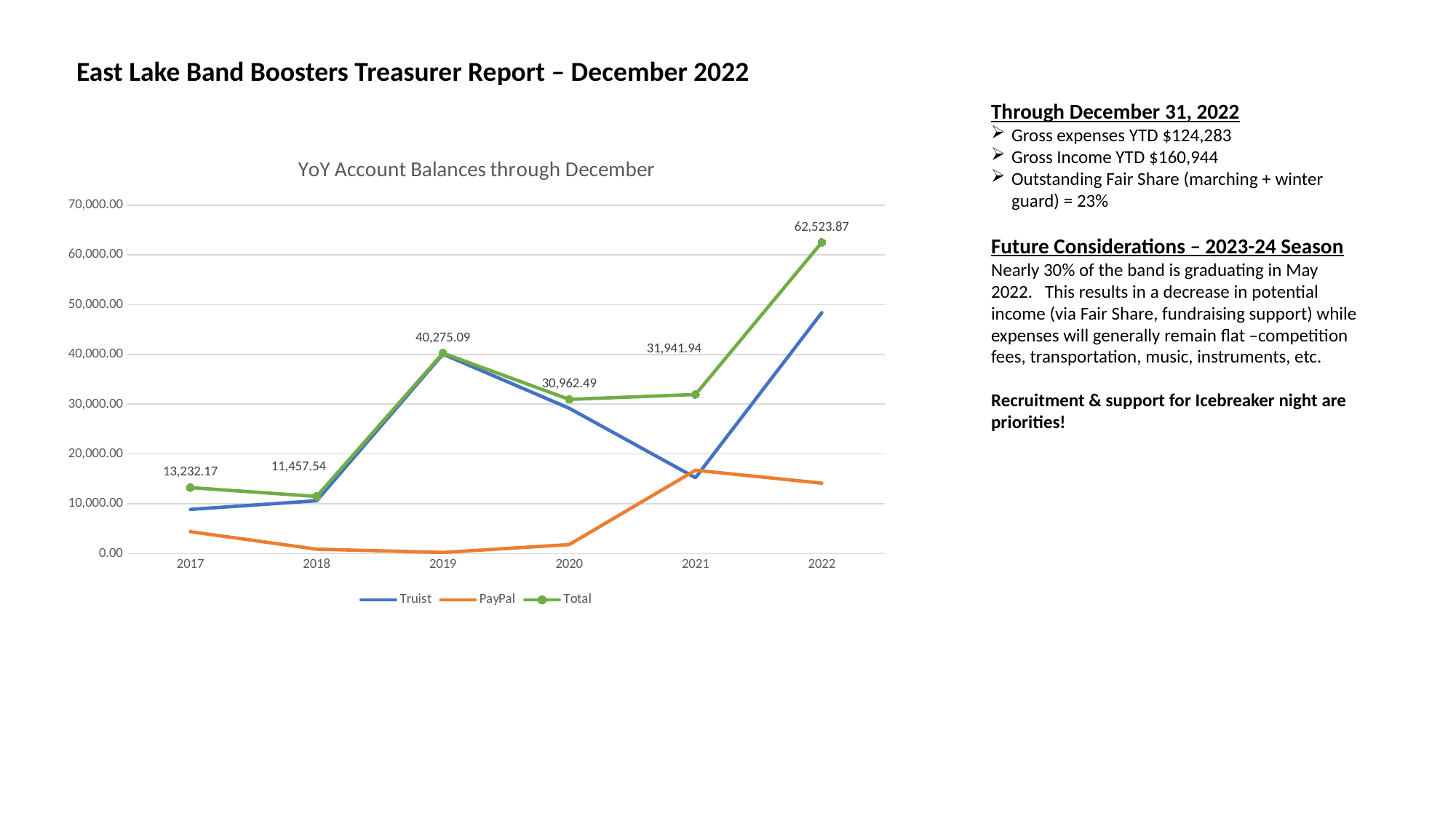
In which year is the Total account balance highest? 2022 How many years are shown on the x axis of the chart? 6 How many series does the chart legend list? 3 Which year has the larger Total balance, 2020 or 2021? 2021 What is the Total account balance for 2017? 13,232.17 Is the Truist balance for 2022 greater or less than 40,000.00? greater What is the difference between the Total balance in 2022 and in 2021? 30,581.93 What type of chart is shown on the slide? Line chart What is the Total account balance for 2019? 40,275.09 What is the Total account balance for 2022? 62,523.87 In which year is the Total account balance lowest? 2018 Is the PayPal balance for 2019 greater or less than 10,000.00? less